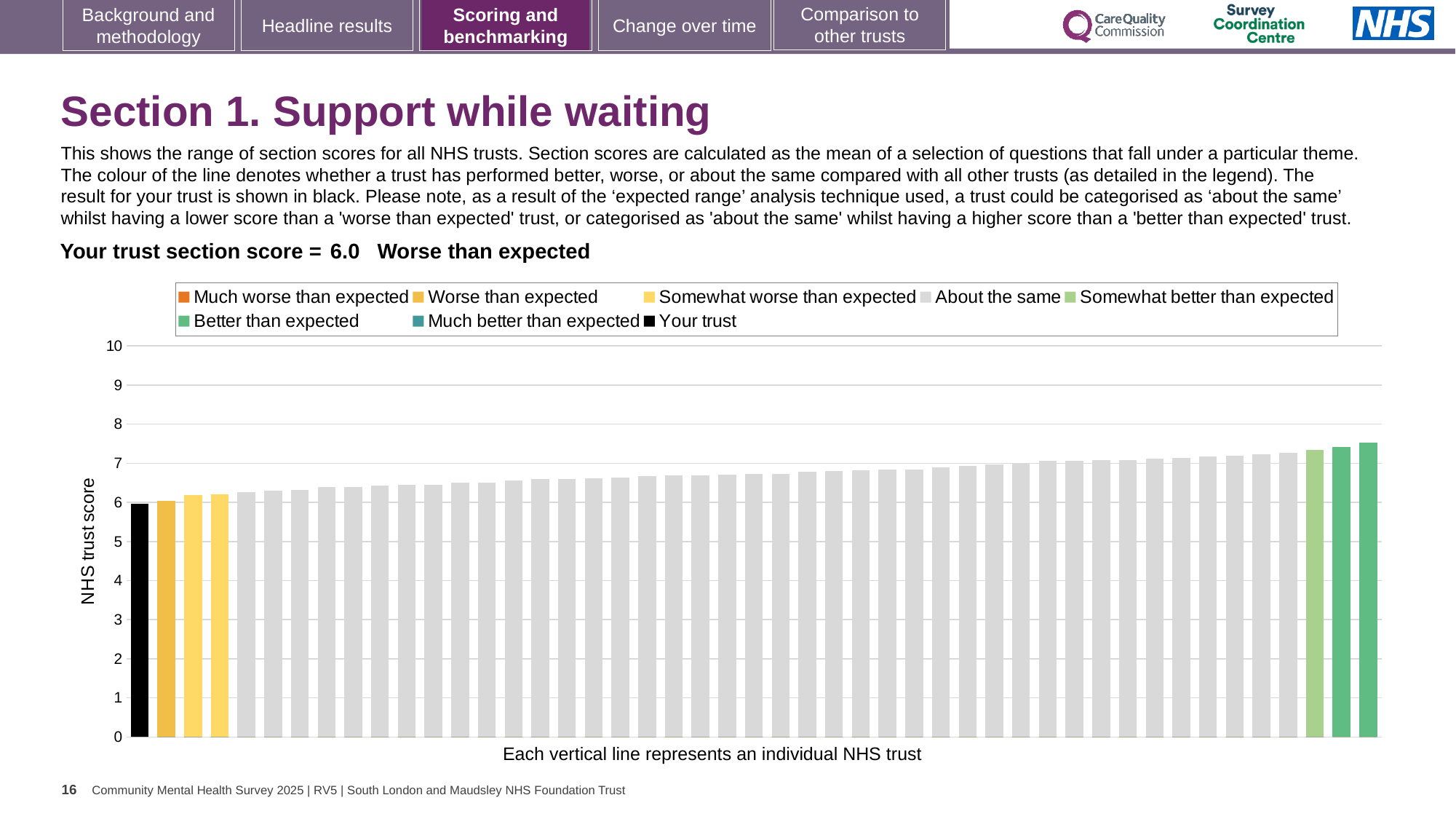
Which trust has the lowest section score on the chart? Your trust What kind of chart is shown on the slide? bar chart Is the highest bar on the chart greater or less than 7? greater Which category does your trust's section score fall into? Worse than expected Do the bar values rise or fall from left to right along the x axis? rise What is the label on the vertical axis of the chart? NHS trust score What is the section score for your trust? 6.0 Is the value for your trust greater or less than 7? less What colour is the bar representing your trust? black How many entries does the chart legend list? 8 How many bars are coloured as 'Better than expected' (green)? 2 Is the highest bar on the chart greater or less than 8? less